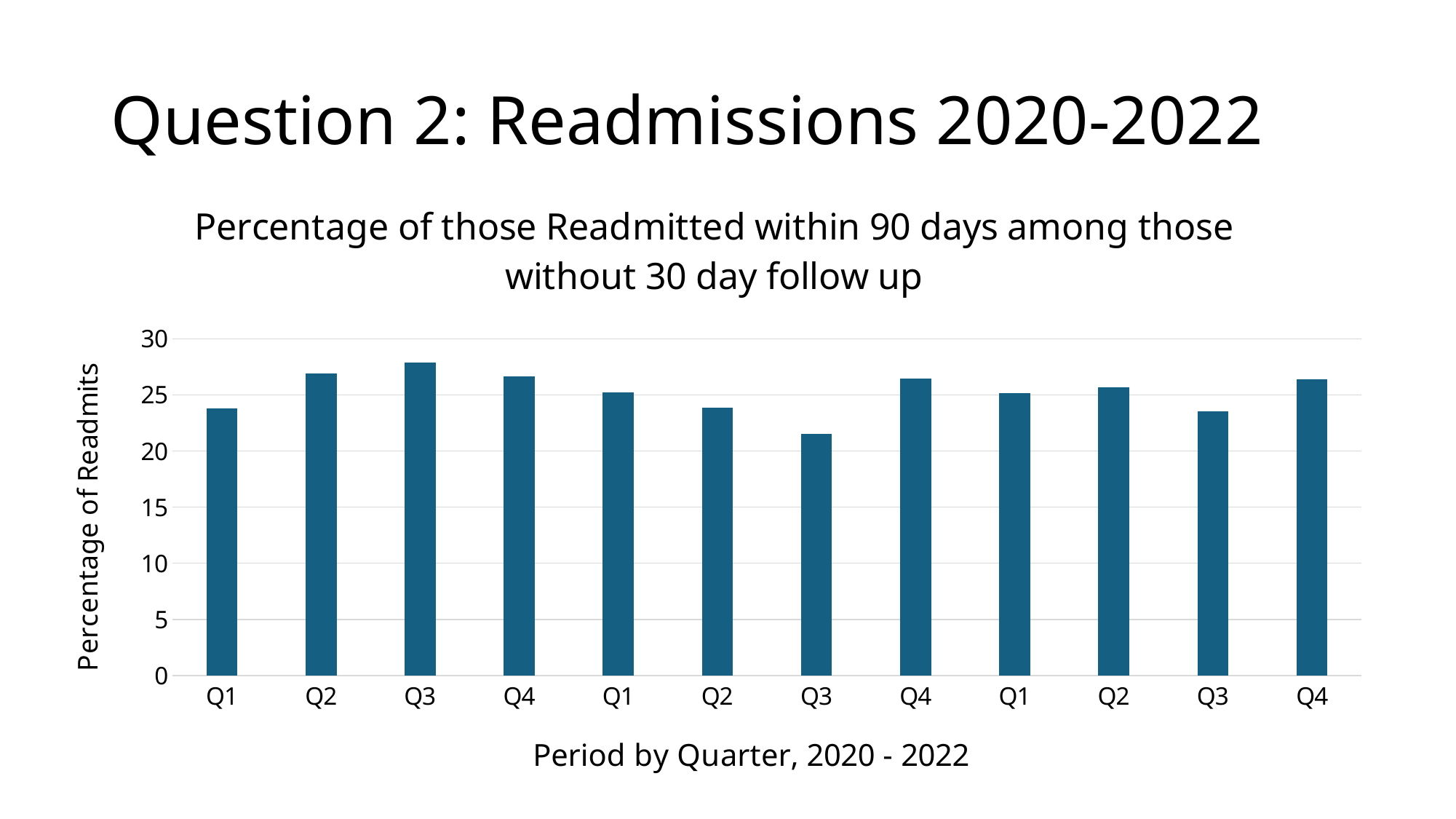
Is the value for the first Q1 bar greater or less than 25? less What is the title of the chart? Percentage of those Readmitted within 90 days among those without 30 day follow up How many bars are plotted in the chart? 12 Which is larger, the first bar (first Q1) or the third bar (first Q3)? the third bar (first Q3) Is the value for the seventh bar (second Q3) greater or less than 20? greater Is the value for the third bar (first Q3) greater or less than 25? greater What is the label of the vertical axis? Percentage of Readmits Which is larger, the second bar (first Q2) or the seventh bar (second Q3)? the second bar (first Q2) Which bar is the tallest in the chart? the third bar (Q3 of the first year) What kind of chart is shown on the slide? bar chart Which bar is the lowest in the chart? the seventh bar (Q3 of the second year)